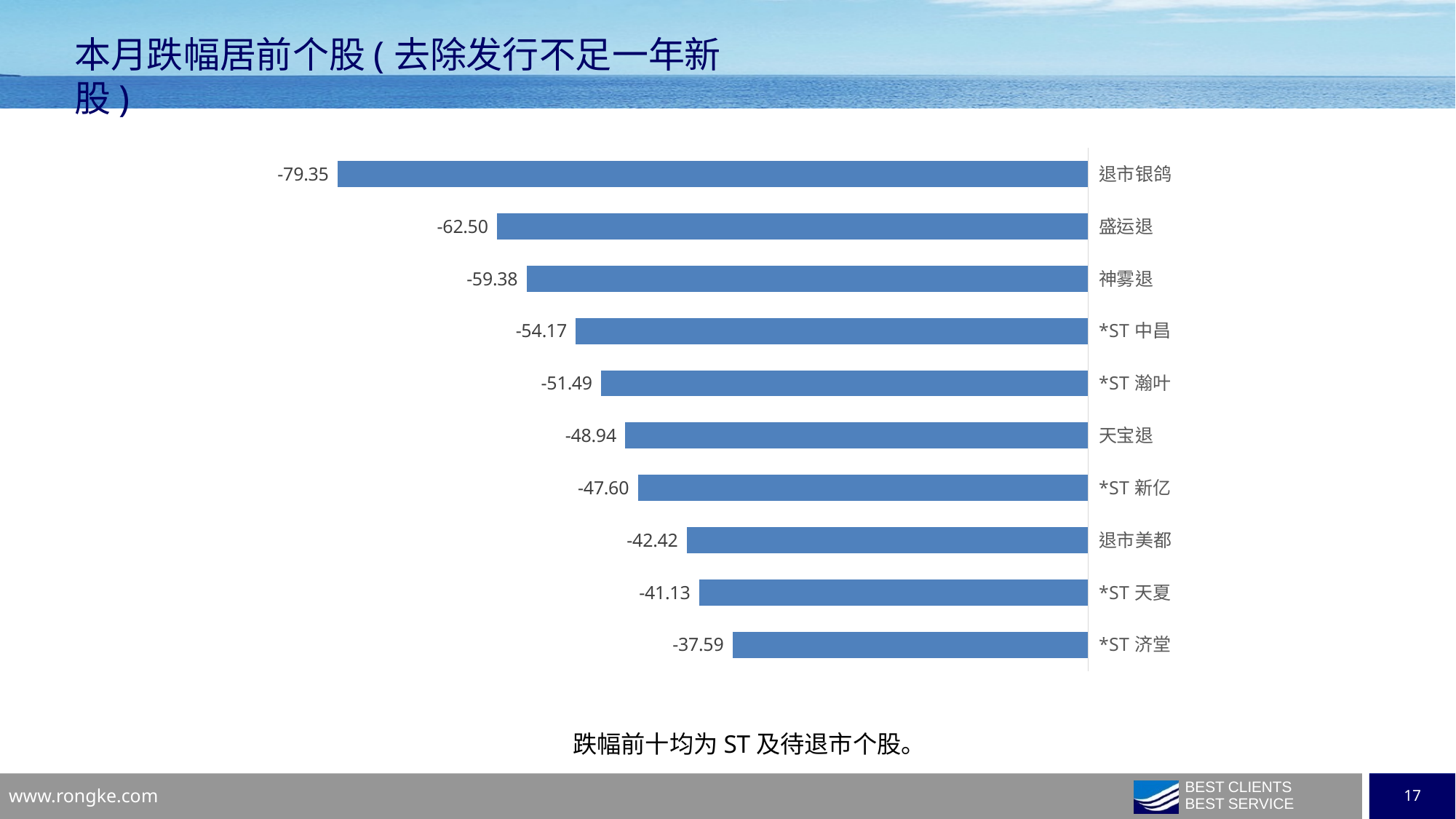
Which stock has the lowest (most negative) value on the chart? 退市银鸽 What is the difference between the values for 盛运退 and 神雾退? 3.12 Which has the larger (less negative) value, 天宝退 or *ST 新亿? *ST 新亿 What is the value shown for *ST 瀚叶? -51.49 What is the value shown for 退市银鸽? -79.35 What kind of chart is shown on the slide? Bar chart What is the difference between the values for 退市银鸽 and *ST 济堂? 41.76 How many stocks are shown on the chart? 10 What is the title of the slide? 本月跌幅居前个股（去除发行不足一年新股） What is the value shown for *ST 济堂? -37.59 What is the value shown for 退市美都? -42.42 Which stock has the highest (least negative) value on the chart? *ST 济堂